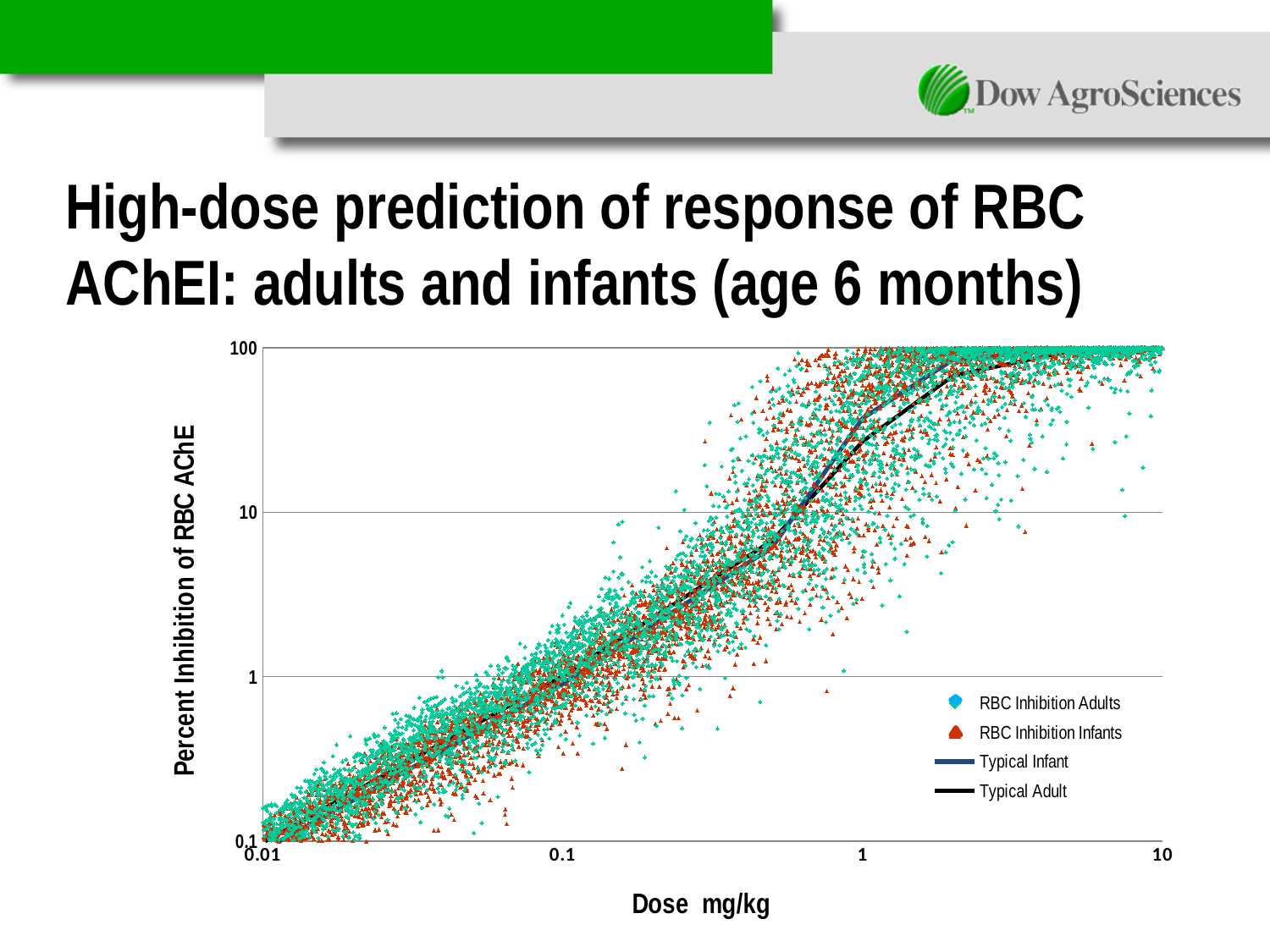
How many series does the legend list? 4 What is the lowest dose shown on the x axis? 0.01 Is the Typical Adult value at a dose of 1 mg/kg greater or less than 10? greater Is the Typical Infant value at a dose of 0.1 mg/kg greater or less than 10? less Which legend entry is drawn with red triangle markers? RBC Inhibition Infants What is the label of the x axis? Dose mg/kg Is the Typical Adult value at a dose of 0.01 mg/kg greater or less than 1? less Does percent inhibition of RBC AChE rise or fall as dose increases along the x axis? Rise What kind of chart is shown on the slide? Scatter plot